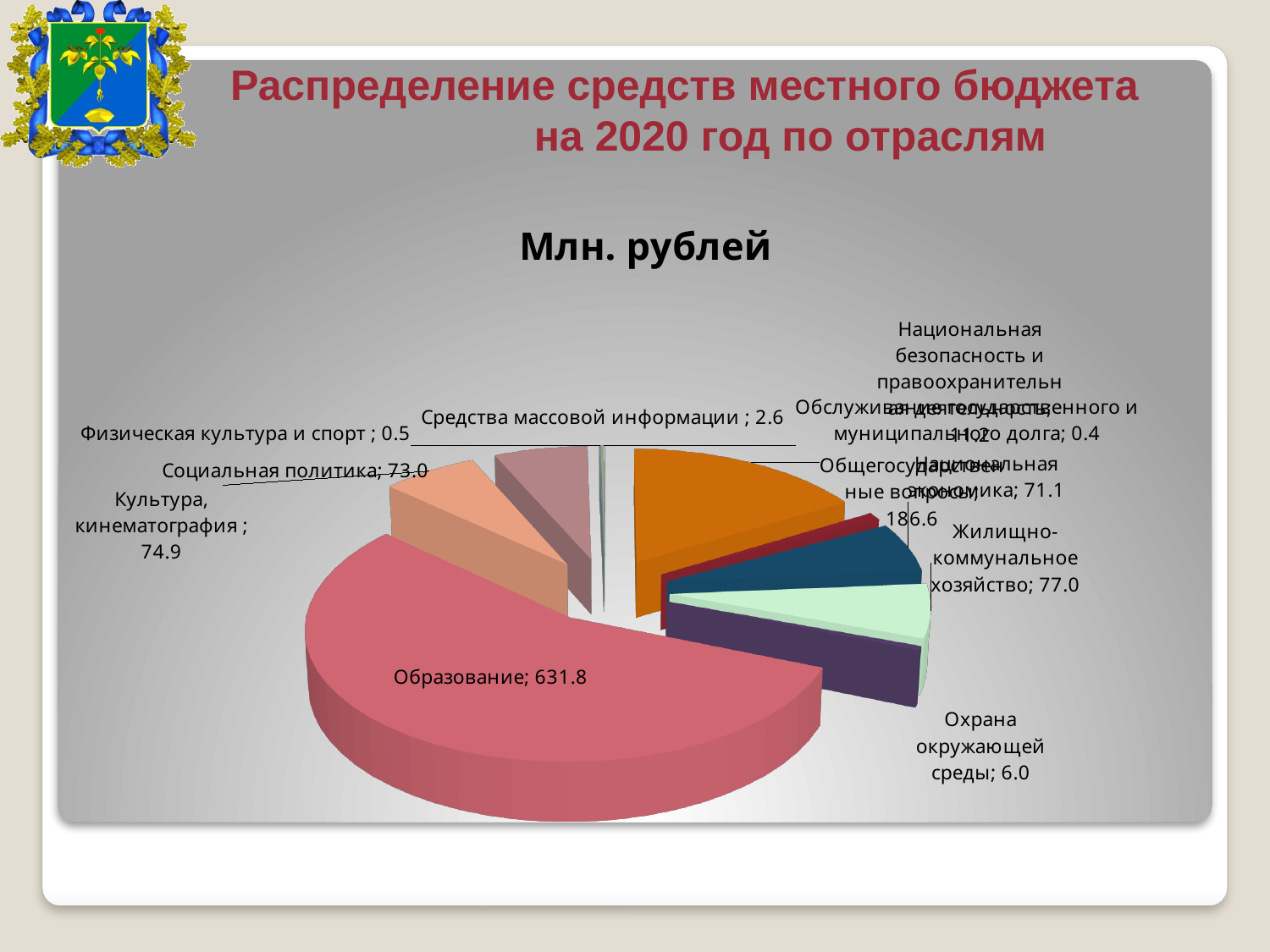
Which is larger, the value for Культура, кинематография or the value for Национальная экономика? Культура, кинематография What is the value for Жилищно-коммунальное хозяйство? 77.0 What is the value for Социальная политика? 73.0 What is the value for Общегосударственные вопросы? 186.6 What is the value for Охрана окружающей среды? 6.0 What is the value for Физическая культура и спорт? 0.5 What kind of chart is shown on the slide? pie chart Which category has the largest value? Образование What is the title of the chart? Млн. рублей What is the difference between the values for Жилищно-коммунальное хозяйство and Социальная политика? 4.0 What is the value for Образование? 631.8 What is the difference between the values for Образование and Общегосударственные вопросы? 445.2